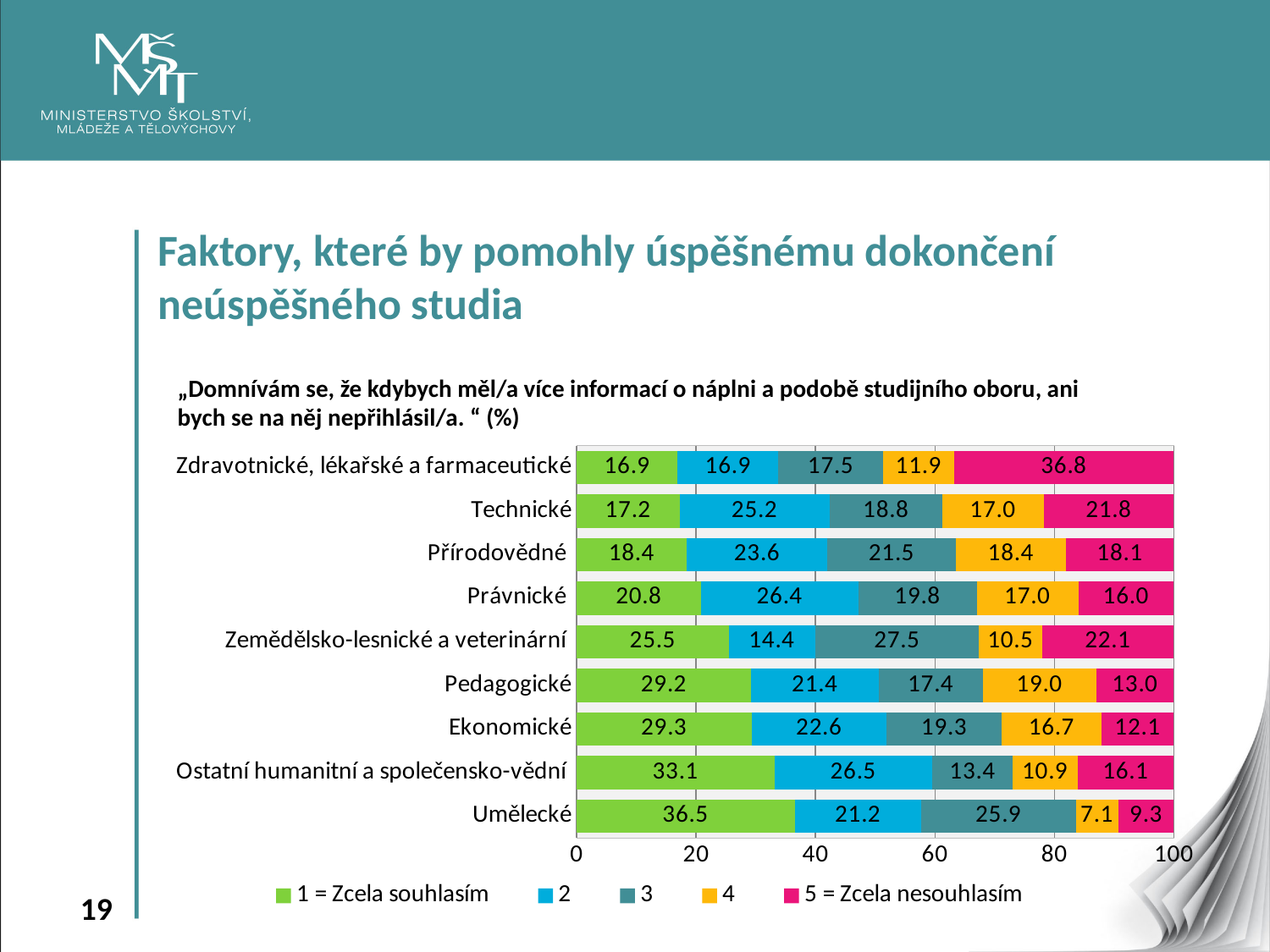
What is the value of series "4" for Ostatní humanitní a společensko-vědní? 10.9 Which category has the highest value for "1 = Zcela souhlasím"? Umělecké What is the value of series "3" for Zemědělsko-lesnické a veterinární? 27.5 What is the value of "5 = Zcela nesouhlasím" for Zdravotnické, lékařské a farmaceutické? 36.8 Which is larger: the "1 = Zcela souhlasím" value for Pedagogické or for Technické? Pedagogické What is the total of the stacked bar for Technické? 100.0 How many categories (study fields) are shown on the chart? 9 Which category has the lowest value for "5 = Zcela nesouhlasím"? Umělecké What is the difference between the "2" values for Právnické and Zemědělsko-lesnické a veterinární? 12.0 How many series does the legend list? 5 What is the value of "1 = Zcela souhlasím" for Umělecké? 36.5 What kind of chart is shown on the slide? Stacked bar chart